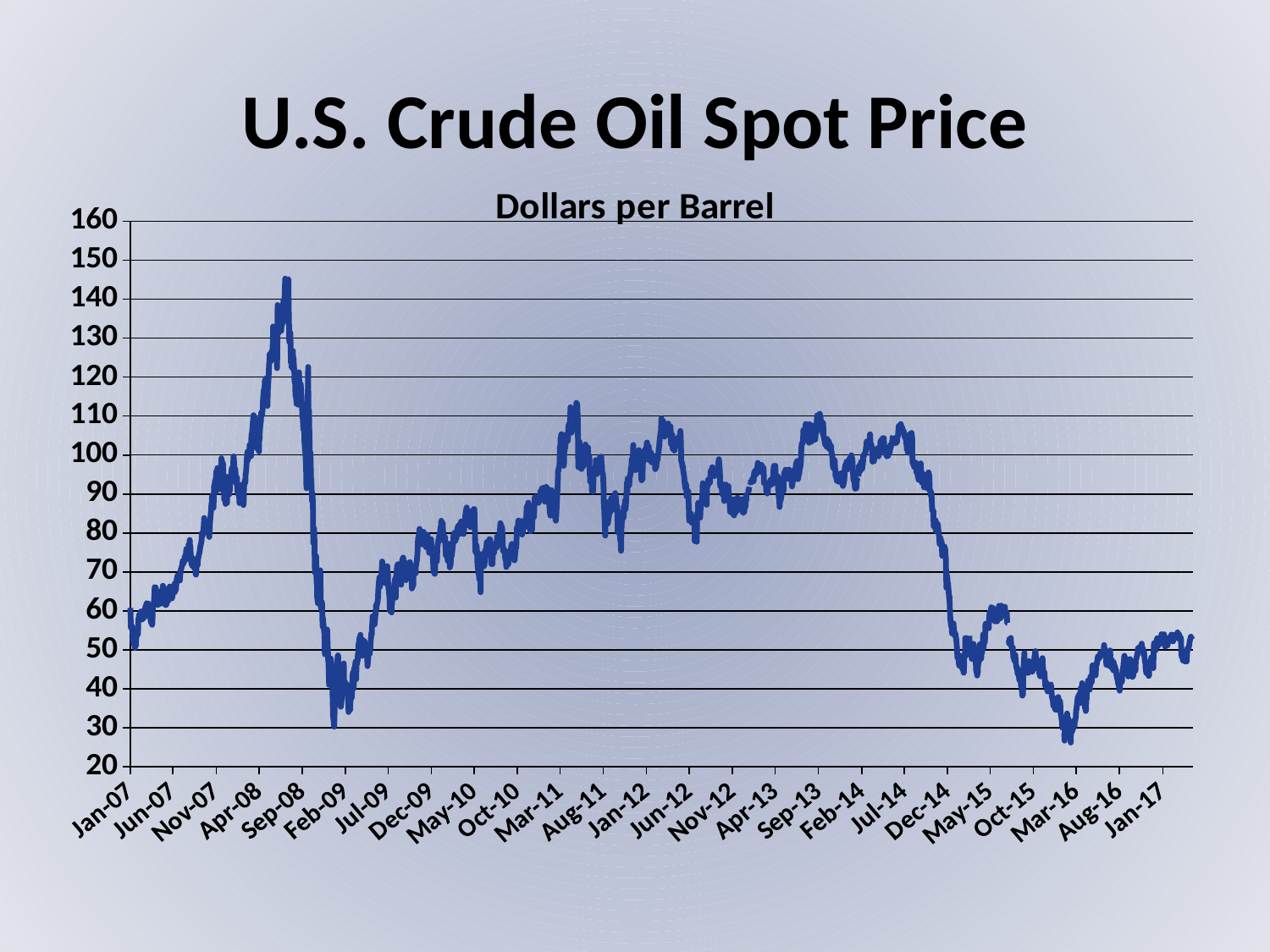
Is the lowest value around Mar-16 greater or less than 40? less What is the title of the chart? U.S. Crude Oil Spot Price Is the peak value of the crude oil price in mid-2008 greater or less than 140? greater Is the value for Jan-17 greater or less than 40? greater Does the crude oil price rise or fall between Feb-09 and Mar-11? rise Which is larger, the value for Sep-13 or the value for Oct-15? Sep-13 How many date labels are shown along the x axis? 25 What unit is the crude oil price plotted in, according to the chart subtitle? Dollars per Barrel What kind of chart is shown on the slide? line chart Does the crude oil price rise or fall between Jul-14 and Dec-14? fall